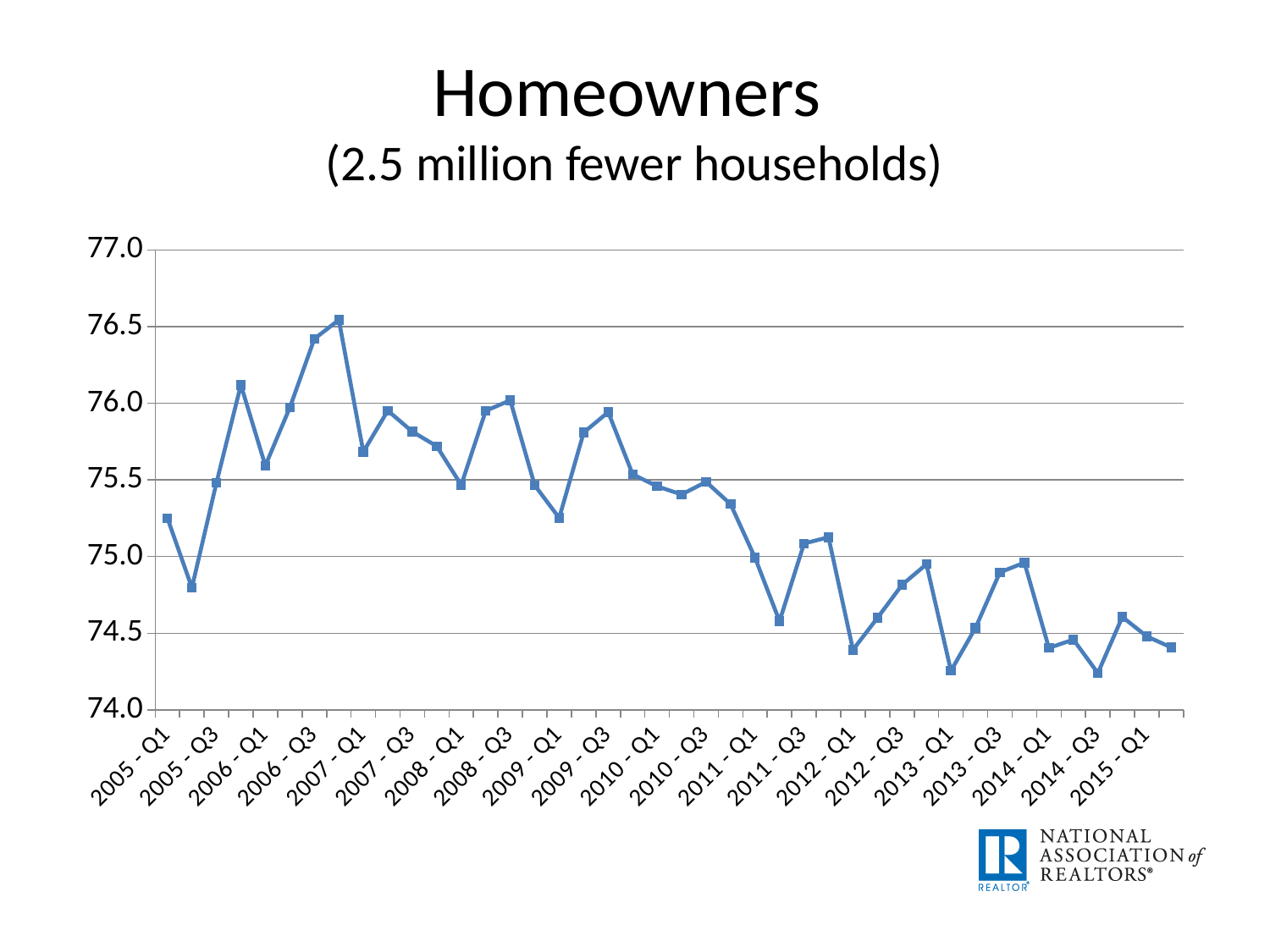
What does the subtitle under the chart title say? (2.5 million fewer households) Which is larger, the value for 2006 - Q3 or the value for 2009 - Q3? 2006 - Q3 Is the value for 2006 - Q3 greater or less than 76.0? greater Is the value for 2005 - Q1 greater or less than 75.0? greater What kind of chart is shown on the slide? line chart Is the value for 2007 - Q1 greater or less than 75.5? greater Which is larger, the value for 2005 - Q1 or the value for 2015 - Q1? 2005 - Q1 Overall, do the values rise or fall from 2005 - Q1 to 2015 - Q1? fall What is the title of the chart on the slide? Homeowners